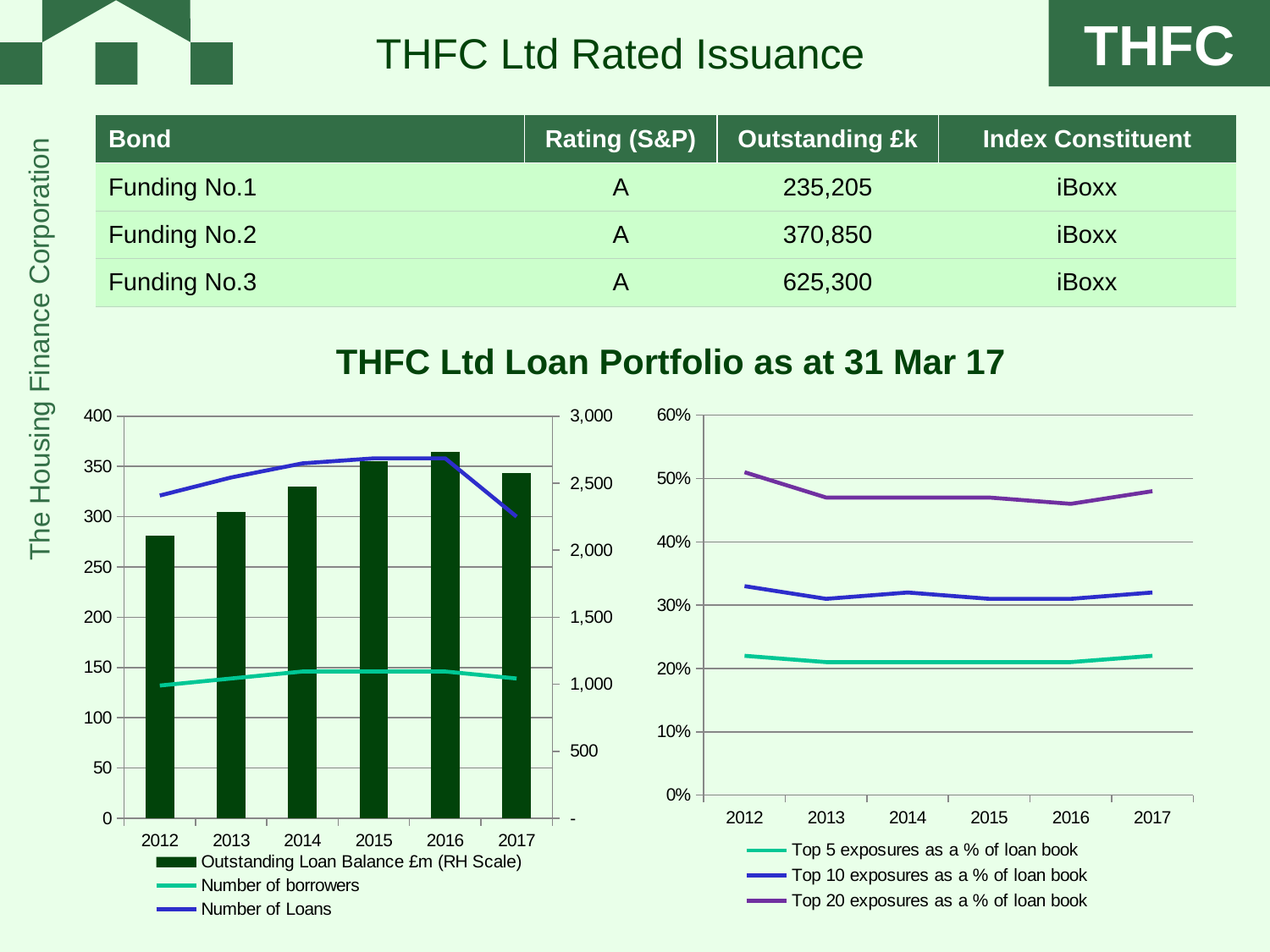
On the left-hand chart, is the Number of borrowers in 2012 greater or less than 150? less On the right-hand chart, which series has the highest values across all years? Top 20 exposures as a % of loan book On the left-hand chart, is the Outstanding Loan Balance for 2016 greater or less than 2,500 on the right-hand scale? greater On the right-hand chart, how many series does the legend list? 3 On the right-hand chart, is the value for Top 20 exposures as a % of loan book in 2016 greater or less than 50%? less On the left-hand chart, how many years are shown on the x axis? 6 What kind of chart is the right-hand chart? Line chart On the left-hand chart, which year has the highest Outstanding Loan Balance bar? 2016 On the left-hand chart, does the Number of Loans rise or fall from 2016 to 2017? fall On the left-hand chart, how many series does the legend list? 3 On the left-hand chart, which year has the lowest Outstanding Loan Balance bar? 2012